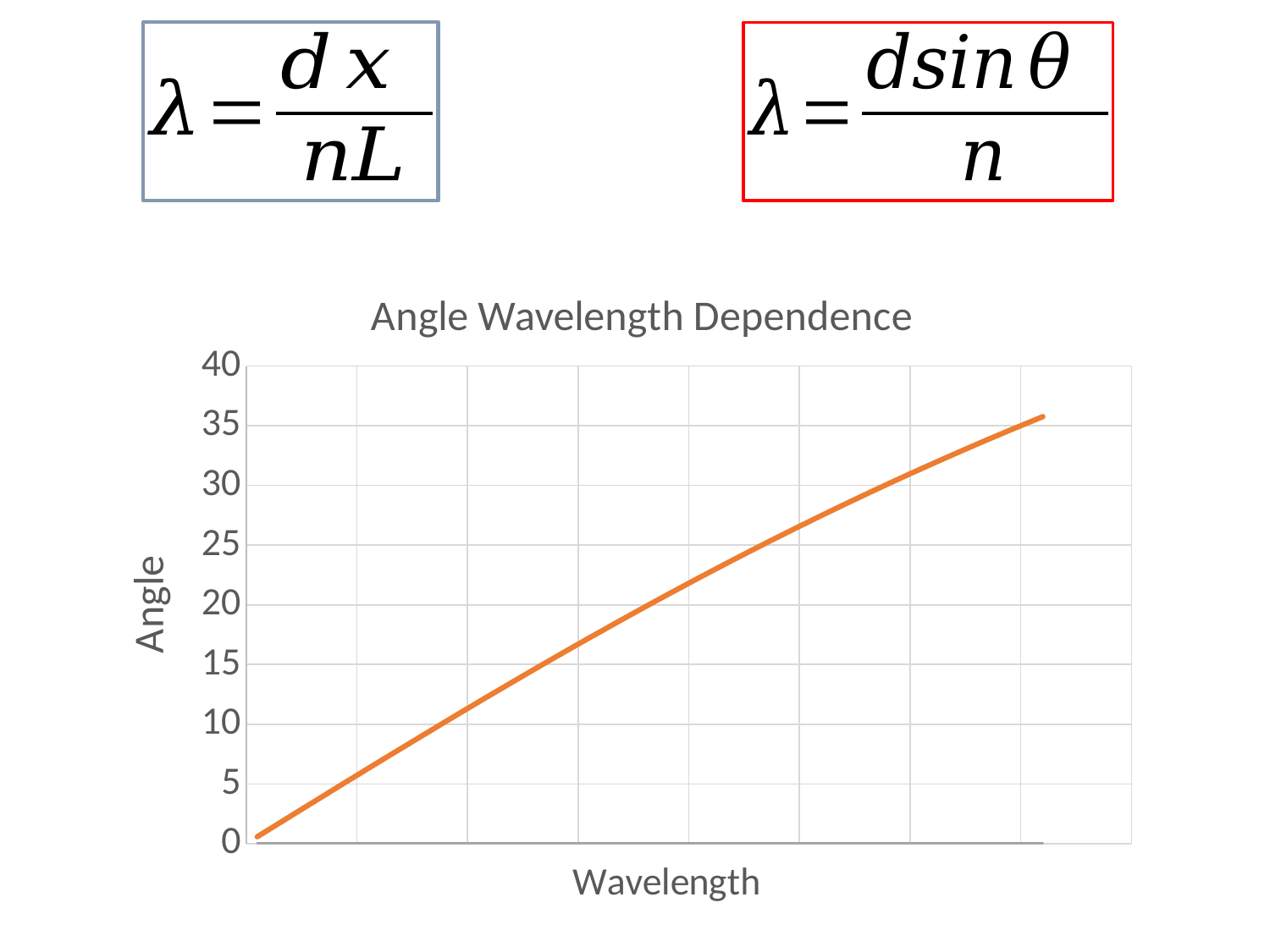
What kind of chart is shown on the slide? line chart Is the highest value reached by the line greater or less than 40? less What is the label of the vertical axis of the chart? Angle What is the title of the chart? Angle Wavelength Dependence What is the highest tick value shown on the vertical axis? 40 Does the plotted angle rise or fall as wavelength increases along the x axis? rise Is the highest value reached by the line greater or less than 30? greater Is the value at the left end of the line greater or less than 5? less How many lines are plotted on the chart? 1